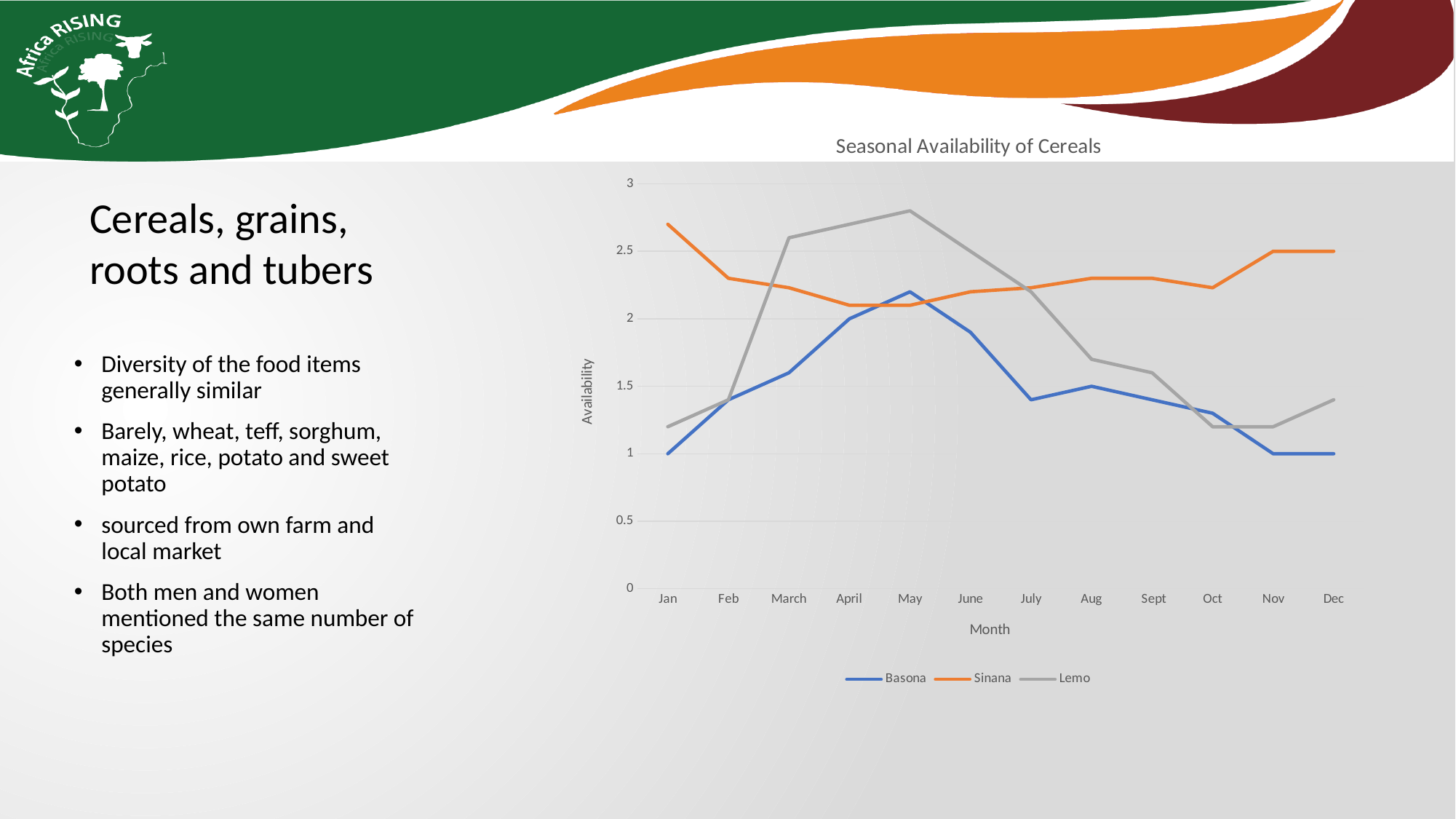
Which series has the higher value in Sept, Sinana or Basona? Sinana In which month does the Lemo series reach its highest value? May How many series does the chart legend list? 3 Is the value for Sinana in Jan greater or less than 2.5? greater What is the title of the chart? Seasonal Availability of Cereals Does the Basona series rise or fall from May to July? fall How many months are plotted along the x axis? 12 What is the availability value for Sinana in Dec? 2.5 What kind of chart is shown on the slide? line chart Is the value for Lemo in March greater or less than 2.5? greater What is the availability value for Basona in Jan? 1 What is the availability value for Basona in April? 2